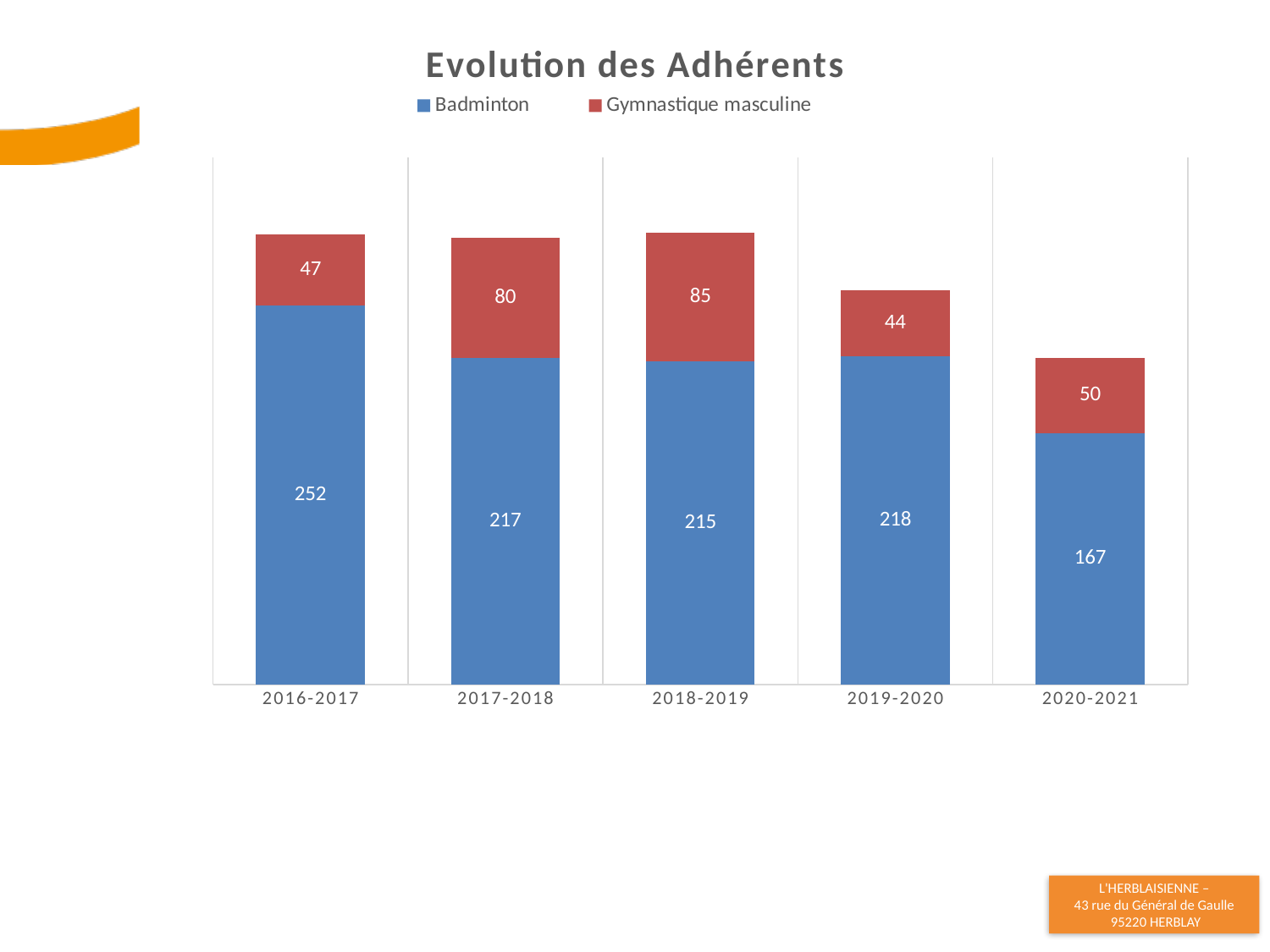
How many series does the legend list? 2 What is the Badminton value for 2016-2017? 252 Which season has the lowest Gymnastique masculine value? 2019-2020 Which season has the highest Badminton value? 2016-2017 How many seasons are shown on the x axis? 5 What kind of chart is shown? Stacked bar chart What is the title of the chart? Evolution des Adhérents What is the Gymnastique masculine value for 2018-2019? 85 What is the difference between the Badminton values for 2016-2017 and 2020-2021? 85 What is the Badminton value for 2020-2021? 167 Which is larger, the Gymnastique masculine value for 2017-2018 or for 2020-2021? 2017-2018 What is the total of the stacked bar for 2019-2020? 262